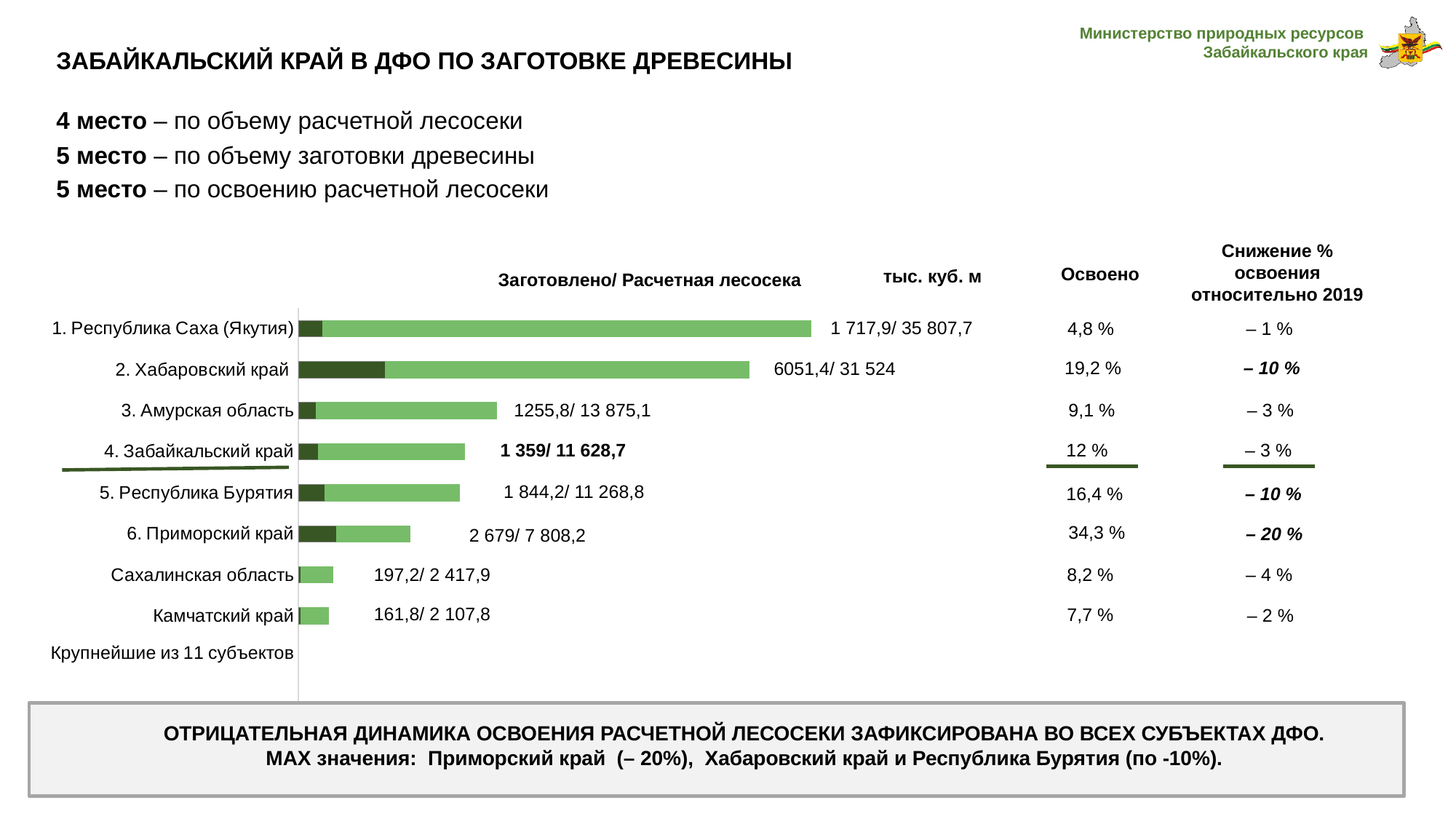
Which region harvested more timber (Заготовлено): Хабаровский край or Амурская область? Хабаровский край Which region has the largest allowable cut (расчетная лесосека) in the chart? Республика Саха (Якутия) What is the difference in allowable cut between Республика Саха (Якутия) and Хабаровский край? 4 283,7 What is the decline in utilisation relative to 2019 (Снижение % освоения) shown for Хабаровский край? – 10 % What is the difference in Освоено percentage between Приморский край and Забайкальский край? 22,3 % What is the Освоено value shown for Приморский край? 34,3 % What are the harvested volume and allowable cut shown for Забайкальский край? 1 359/ 11 628,7 Which region has the highest Освоено percentage? Приморский край What are the harvested volume and allowable cut (Заготовлено/ Расчетная лесосека) shown for Республика Саха (Якутия)? 1 717,9/ 35 807,7 Which region has the smallest allowable cut (расчетная лесосека) in the chart? Камчатский край What kind of chart is shown on the slide? Bar chart How many regions are plotted as bars in the chart? 8